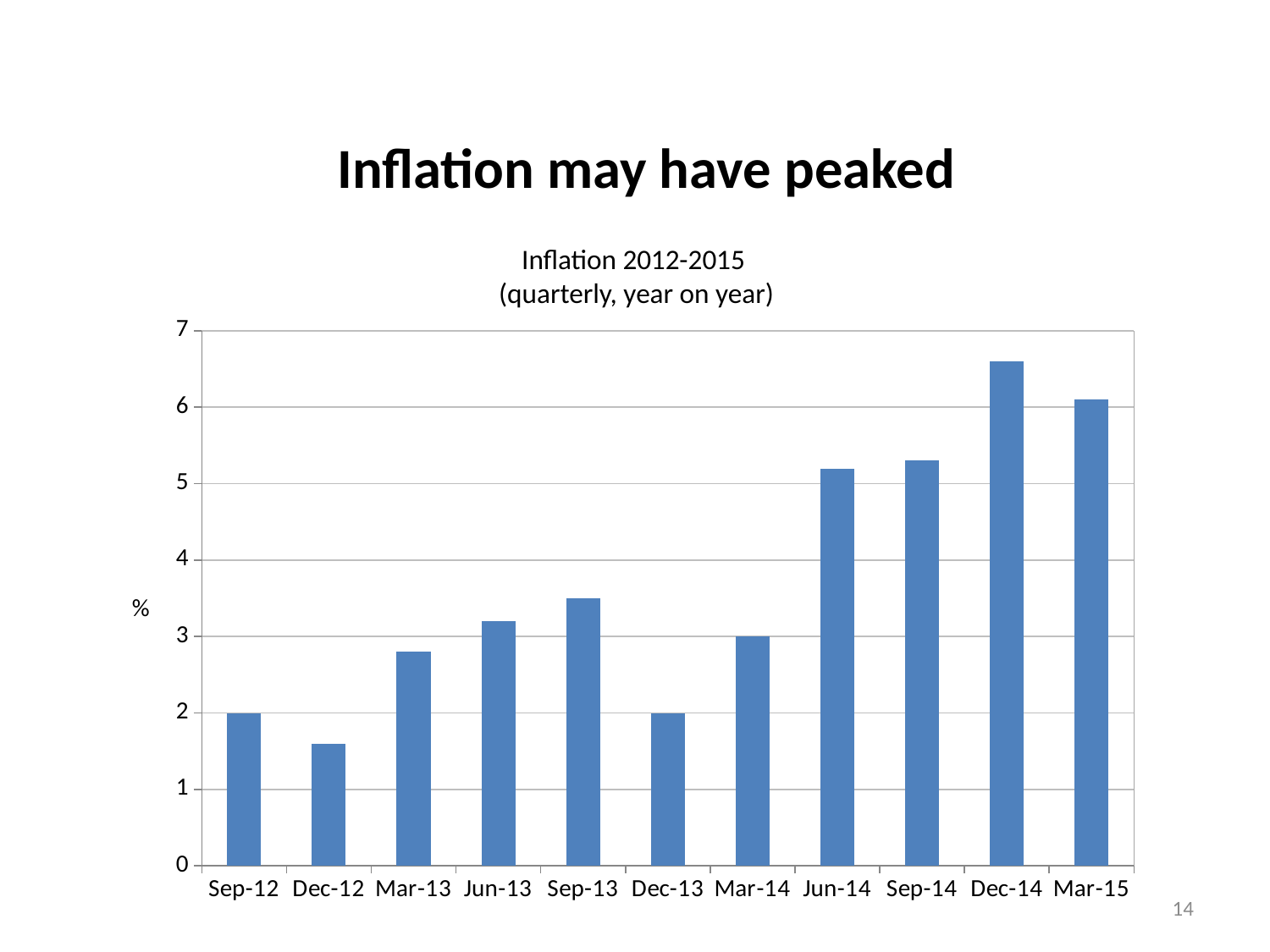
How many quarters are plotted on the chart? 11 What kind of chart is shown on the slide? bar chart Which quarter has the lowest inflation value? Dec-12 Which is larger, the inflation value for Dec-14 or for Mar-15? Dec-14 Is the inflation value for Dec-14 greater or less than 6? greater Overall, do the inflation values rise or fall from Sep-12 to Mar-15? rise Is the inflation value for Sep-13 greater or less than 4? less Is the inflation value for Jun-14 greater or less than 5? greater Which quarter has the highest inflation value? Dec-14 What is the title of the chart? Inflation 2012-2015 (quarterly, year on year)